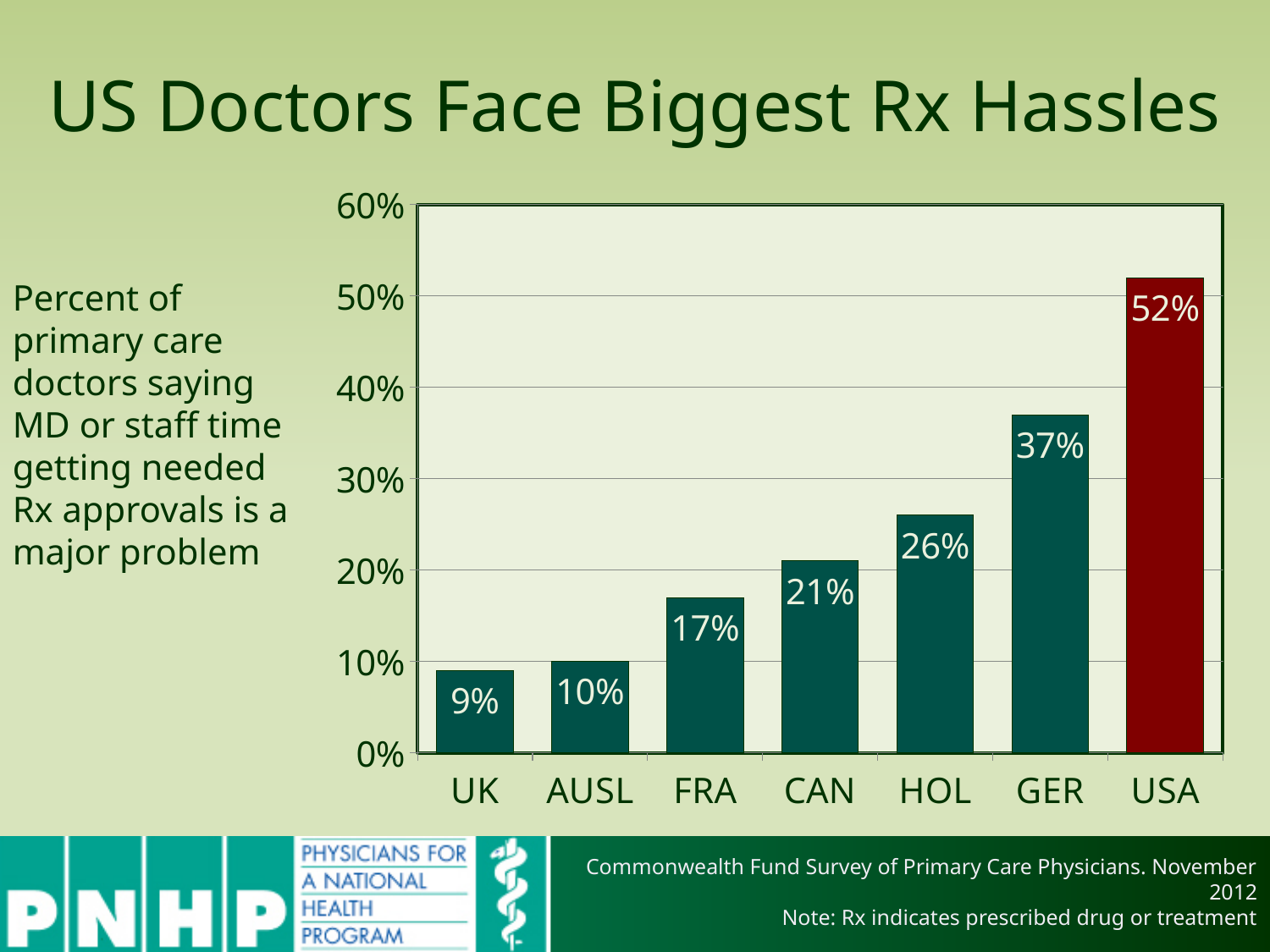
Which country has the highest value? USA What is the value for FRA? 17% What is the difference between the values for CAN and AUSL? 11% Which is larger, the value for GER or the value for HOL? GER What is the value for USA? 52% Is the value for GER greater or less than 40%? less How many countries are shown on the chart? 7 What kind of chart is shown on the slide? bar chart What is the difference between the values for USA and GER? 15% What is the value for HOL? 26% Which country has the lowest value? UK Do the values rise or fall from left to right along the x axis? rise